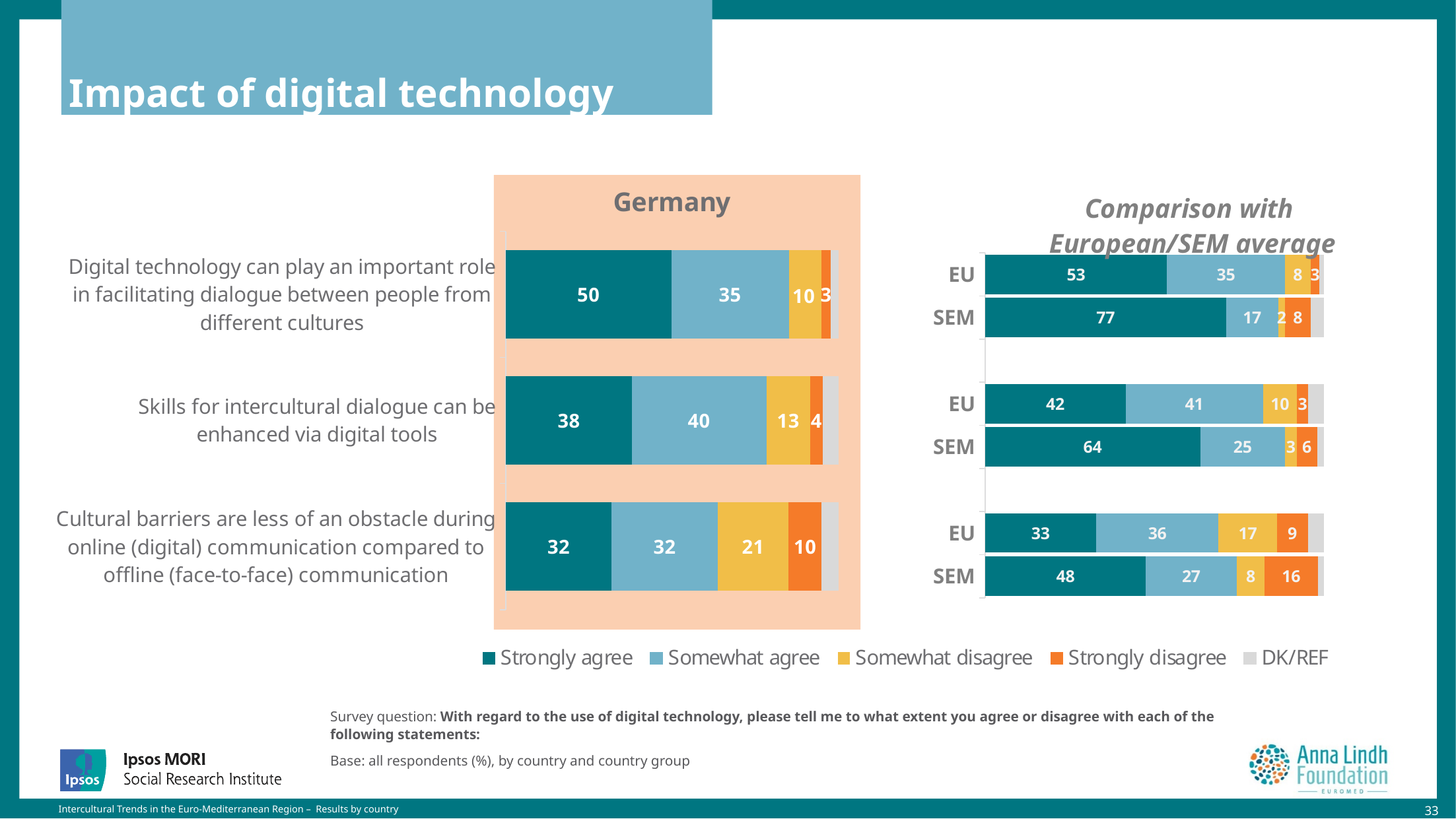
How many statements are shown in the Germany chart? 3 How many series does the legend list? 5 In the Germany chart, which statement has the larger Somewhat agree value: the skills for intercultural dialogue statement or the digital technology dialogue statement? Skills for intercultural dialogue can be enhanced via digital tools What kind of chart is the Germany chart? Stacked bar chart In the Germany chart, which statement has the highest Strongly agree value? Digital technology can play an important role in facilitating dialogue between people from different cultures In the Germany chart, which statement has the lowest Strongly disagree value? Digital technology can play an important role in facilitating dialogue between people from different cultures In the Comparison with European/SEM average chart, what is the SEM Strongly agree value for the first statement (digital technology facilitating dialogue)? 77 In the Germany chart, what is the Somewhat disagree value for the statement that cultural barriers are less of an obstacle during online communication? 21 In the Germany chart, what is the difference between the Strongly agree values for the digital technology dialogue statement and the cultural barriers statement? 18 In the Comparison with European/SEM average chart, what is the EU Strongly disagree value for the third statement (cultural barriers less of an obstacle online)? 9 In the Comparison with European/SEM average chart, what is the difference between the SEM and EU Strongly agree values for the second statement (skills enhanced via digital tools)? 22 In the Germany chart, what percentage strongly agree that skills for intercultural dialogue can be enhanced via digital tools? 38